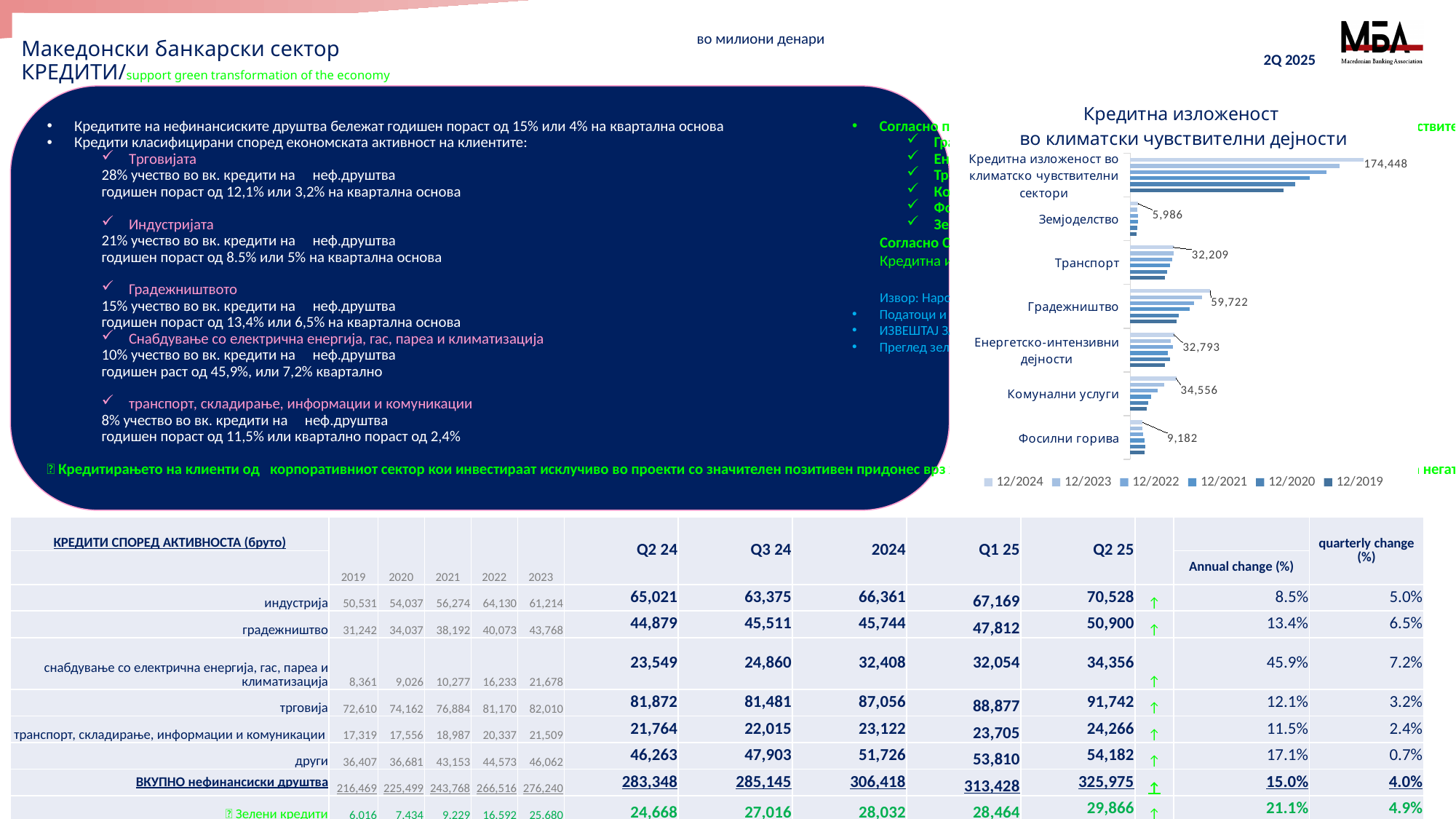
Which has the larger labelled 12/2024 value, Комунални услуги or Енергетско-интензивни дејности? Комунални услуги Among the individual sectors (excluding the total), which has the highest labelled 12/2024 value? Градежништво What kind of chart is shown on the slide? bar chart Which series is shown in the darkest blue in the legend? 12/2019 How many categories are shown on the chart's vertical axis? 7 What is the title of the chart? Кредитна изложеност во климатски чувствителни дејности How many series does the chart legend list? 6 What is the labelled 12/2024 value for Кредитна изложеност во климатско чувствителни сектори? 174,448 What is the labelled 12/2024 value for Фосилни горива? 9,182 What is the difference between the labelled 12/2024 values for Градежништво and Транспорт? 27,513 Among the individual sectors (excluding the total), which has the lowest labelled 12/2024 value? Земјоделство What is the labelled 12/2024 value for Градежништво? 59,722